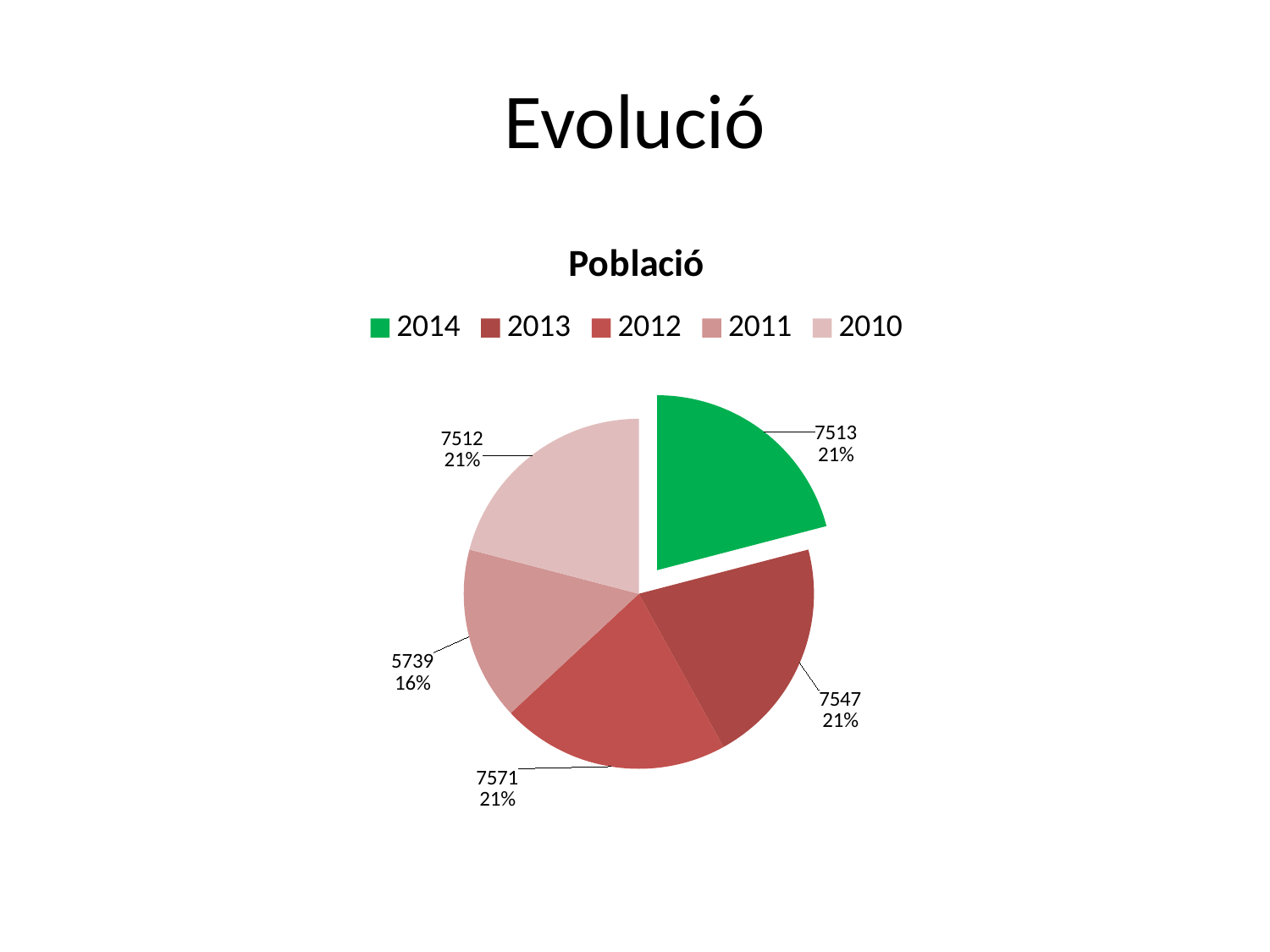
What is the population value shown for 2011? 5739 What is the population value shown for 2014? 7513 What is the population value shown for 2012? 7571 What is the population value shown for 2010? 7512 Which year has the smallest slice of the pie? 2011 Which year has the largest value in the pie chart? 2012 What is the difference between the values for 2013 and 2014? 34 What type of chart is shown on the slide? Pie chart How many slices does the pie chart have? 5 What is the title of the chart? Població What share of the pie does 2011 represent? 16% What share of the pie does 2013 represent? 21%